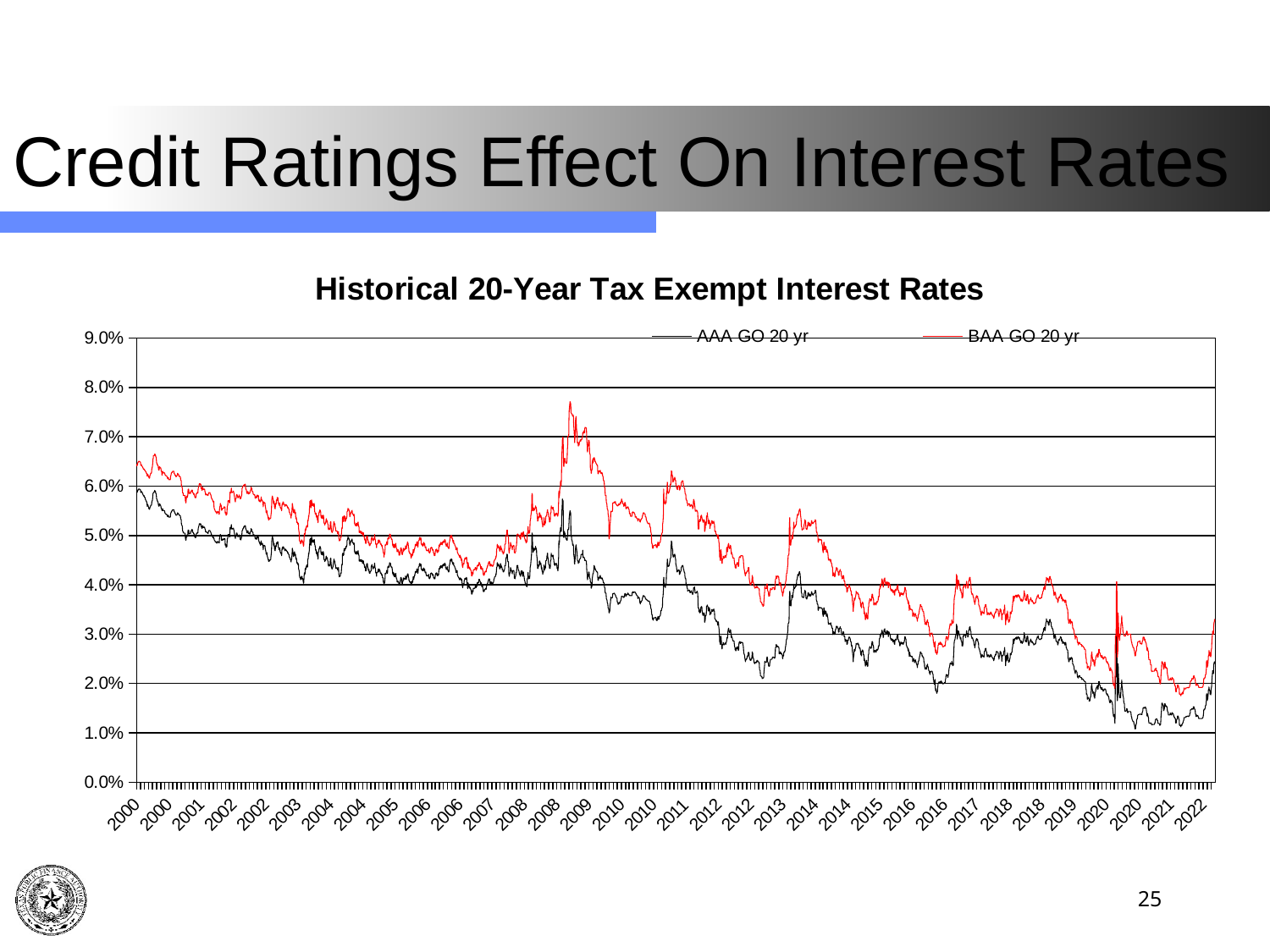
What are the two series named in the legend? AAA GO 20 yr and BAA GO 20 yr Which series is generally higher across the chart, AAA GO 20 yr or BAA GO 20 yr? BAA GO 20 yr Is the value of the BAA GO 20 yr series at the start of 2000 greater or less than 6.0%? greater Overall, do the interest rates rise or fall from 2000 to 2022? fall Is the value of the AAA GO 20 yr series at the start of 2000 greater or less than 5.0%? greater How many series does the legend list? 2 What is the highest value shown on the y axis? 9.0% Is the peak value of the BAA GO 20 yr series around 2008 greater or less than 7.0%? greater Around which year does the BAA GO 20 yr series reach its highest value? 2008 What is the title of the chart? Historical 20-Year Tax Exempt Interest Rates What kind of chart is shown on the slide? line chart